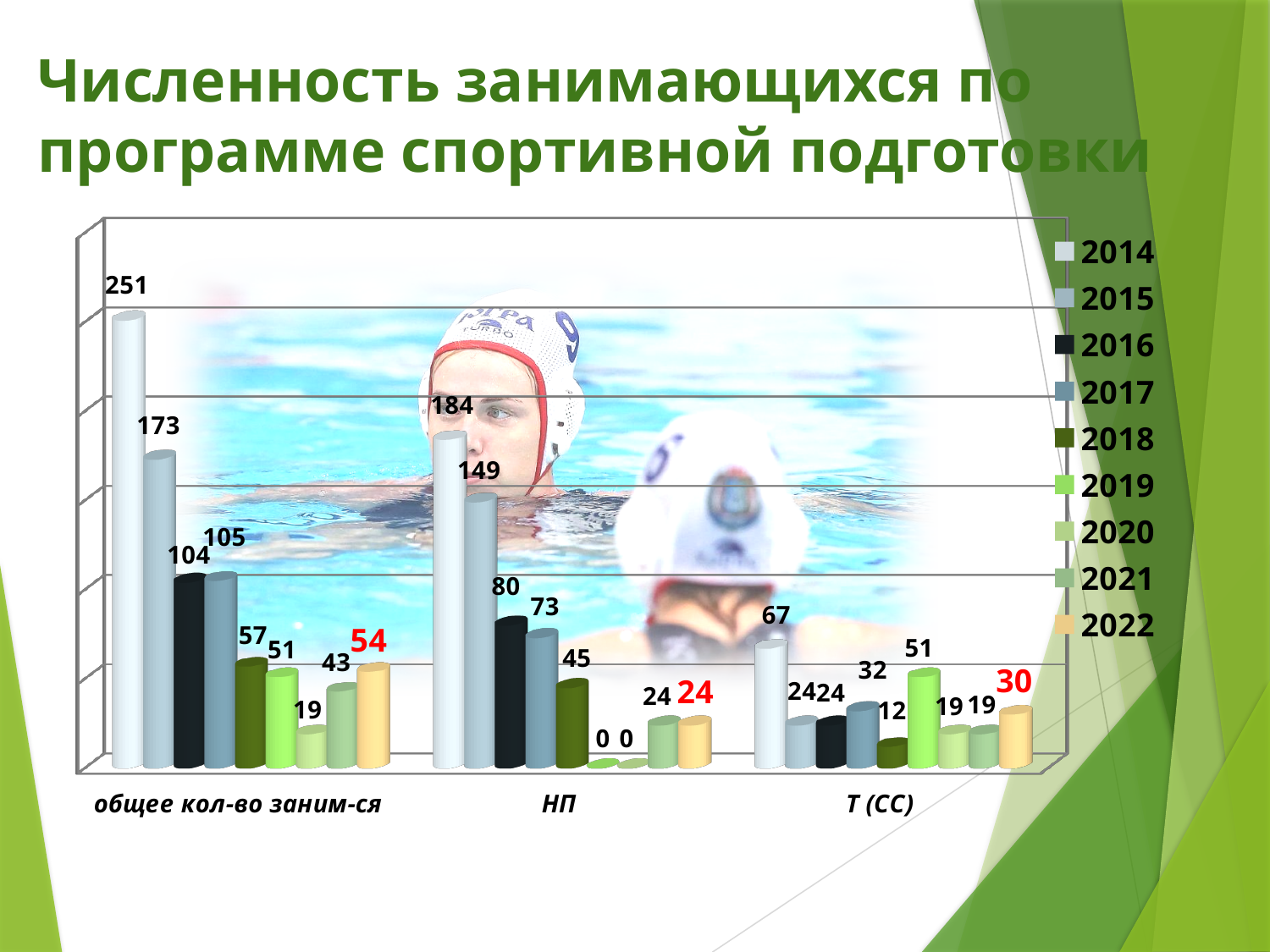
What is the value for 2022 in the 'НП' category? 24 Which years have a value of 0 in the 'НП' category? 2019 and 2020 What kind of chart is shown on the slide? Bar chart How many series does the legend list? 9 What is the value for 2019 in the 'Т (СС)' category? 51 Which year has the highest value in the 'НП' category? 2014 How many categories are shown on the x axis? 3 What is the difference between the 2014 and 2015 values in the 'общее кол-во заним-ся' category? 78 Which is larger in the 'Т (СС)' category: the value for 2017 or the value for 2022? 2017 What is the value for 2014 in the 'общее кол-во заним-ся' category? 251 What is the value for 2018 in the 'Т (СС)' category? 12 Which year has the lowest value in the 'общее кол-во заним-ся' category? 2020